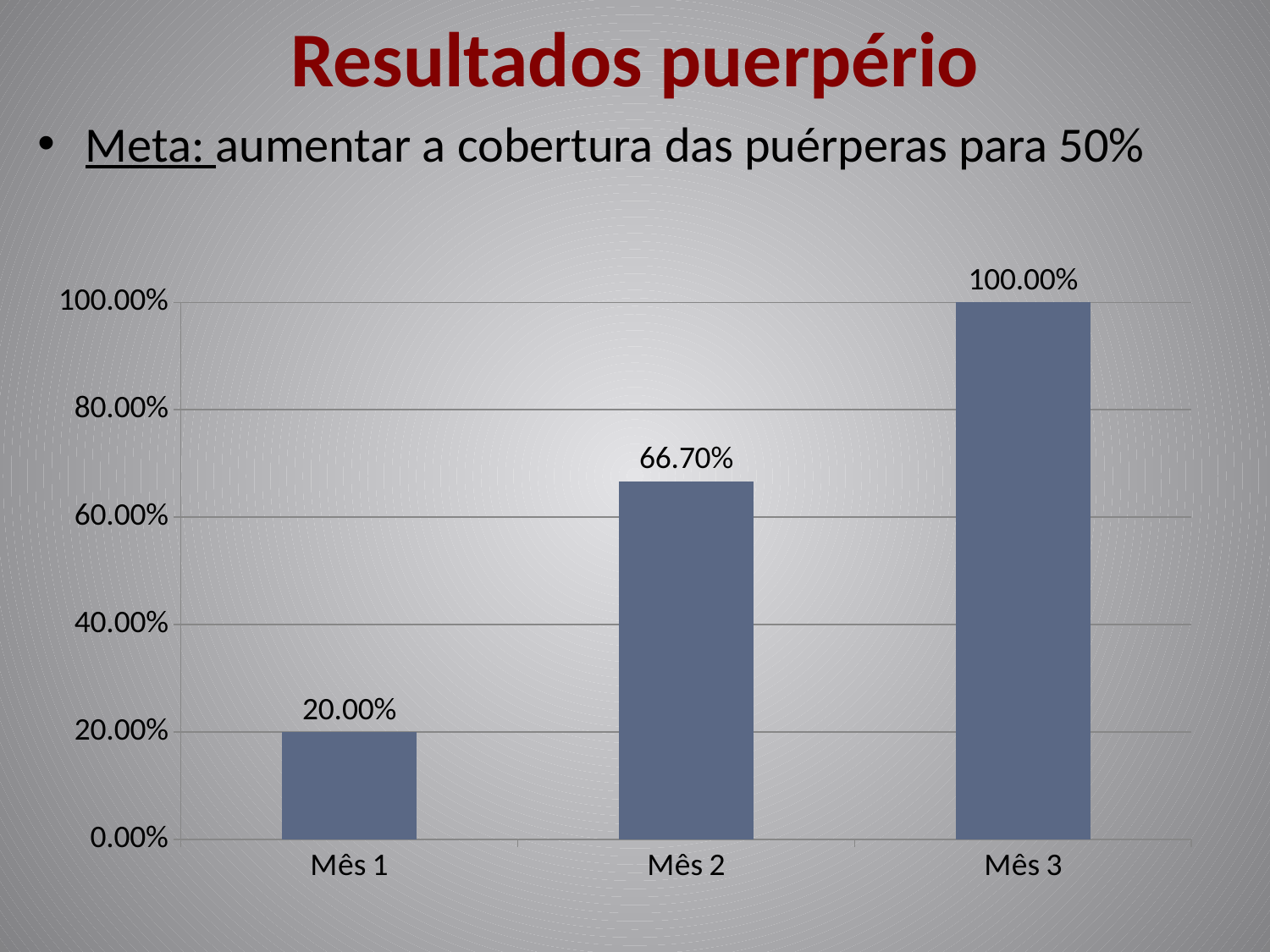
What is the value for Mês 3? 100.00% How many categories are shown on the x axis? 3 What kind of chart is shown on the slide? bar chart Which category has the lowest value? Mês 1 What is the value for Mês 2? 66.70% Do the values rise or fall from Mês 1 to Mês 3? rise Which is larger, the value for Mês 2 or the value for Mês 1? Mês 2 What is the difference between the values for Mês 3 and Mês 1? 80.00% Which category has the highest value? Mês 3 What is the difference between the values for Mês 2 and Mês 1? 46.70% Is the value for Mês 2 greater or less than 60.00%? greater What is the value for Mês 1? 20.00%